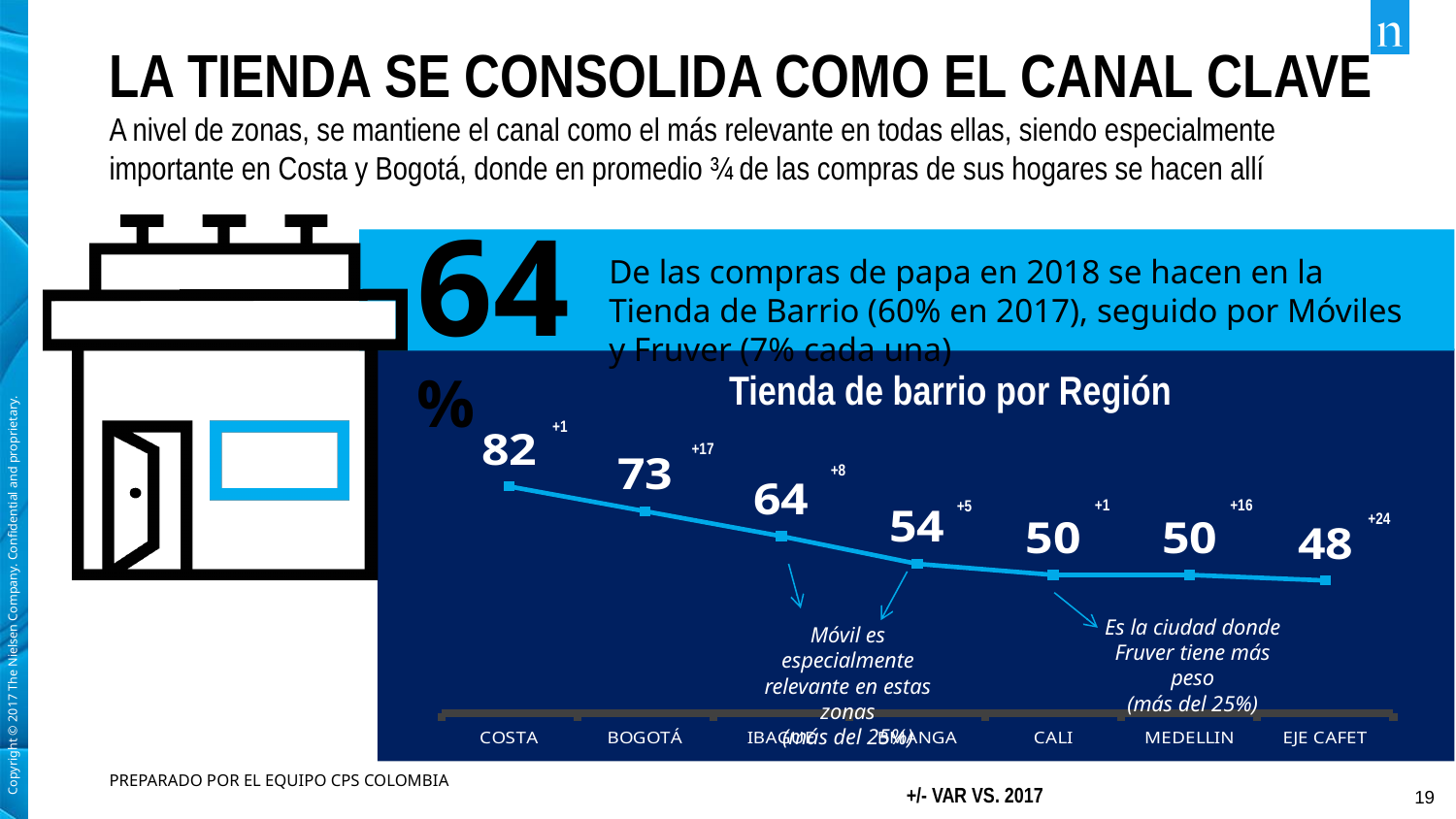
In the chart 'Tienda de barrio por Región', which region has the highest value? COSTA In the chart 'Tienda de barrio por Región', which is larger, the value for BOGOTÁ or the value for CALI? BOGOTÁ In the chart 'Tienda de barrio por Región', do the values rise or fall from left to right along the x axis? fall In the chart 'Tienda de barrio por Región', what is the value for MEDELLIN? 50 What kind of chart is 'Tienda de barrio por Región'? line chart In the chart 'Tienda de barrio por Región', what is the value for BOGOTÁ? 73 In the chart 'Tienda de barrio por Región', what is the value for EJE CAFET? 48 In the chart 'Tienda de barrio por Región', what is the value for CALI? 50 In the chart 'Tienda de barrio por Región', what is the value for COSTA? 82 In the chart 'Tienda de barrio por Región', what is the difference between the values for COSTA and BOGOTÁ? 9 How many regions are plotted in the chart 'Tienda de barrio por Región'? 7 In the chart 'Tienda de barrio por Región', which region has the lowest value? EJE CAFET